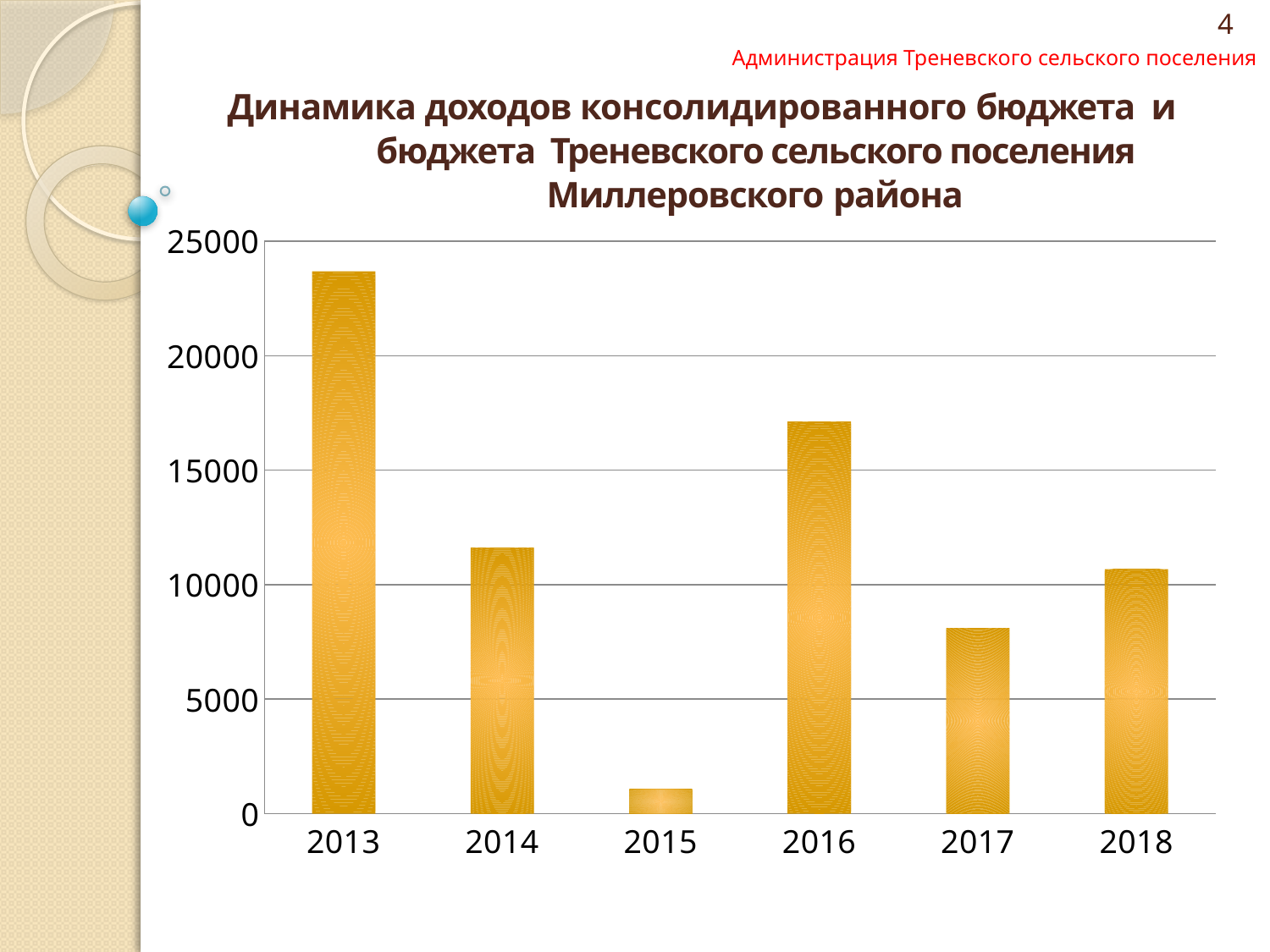
Is the value for 2016 greater or less than 15000? greater Which year has the highest bar in the chart? 2013 Which year has the larger value, 2014 or 2016? 2016 Is the value for 2015 greater or less than 5000? less What kind of chart is shown on the slide? bar chart Which year has the larger value, 2017 or 2018? 2018 Which year has the lowest bar in the chart? 2015 Do the values rise or fall from 2013 to 2015? fall How many years are shown on the x axis of the chart? 6 What is the highest value shown on the vertical axis of the chart? 25000 Is the value for 2013 greater or less than 20000? greater